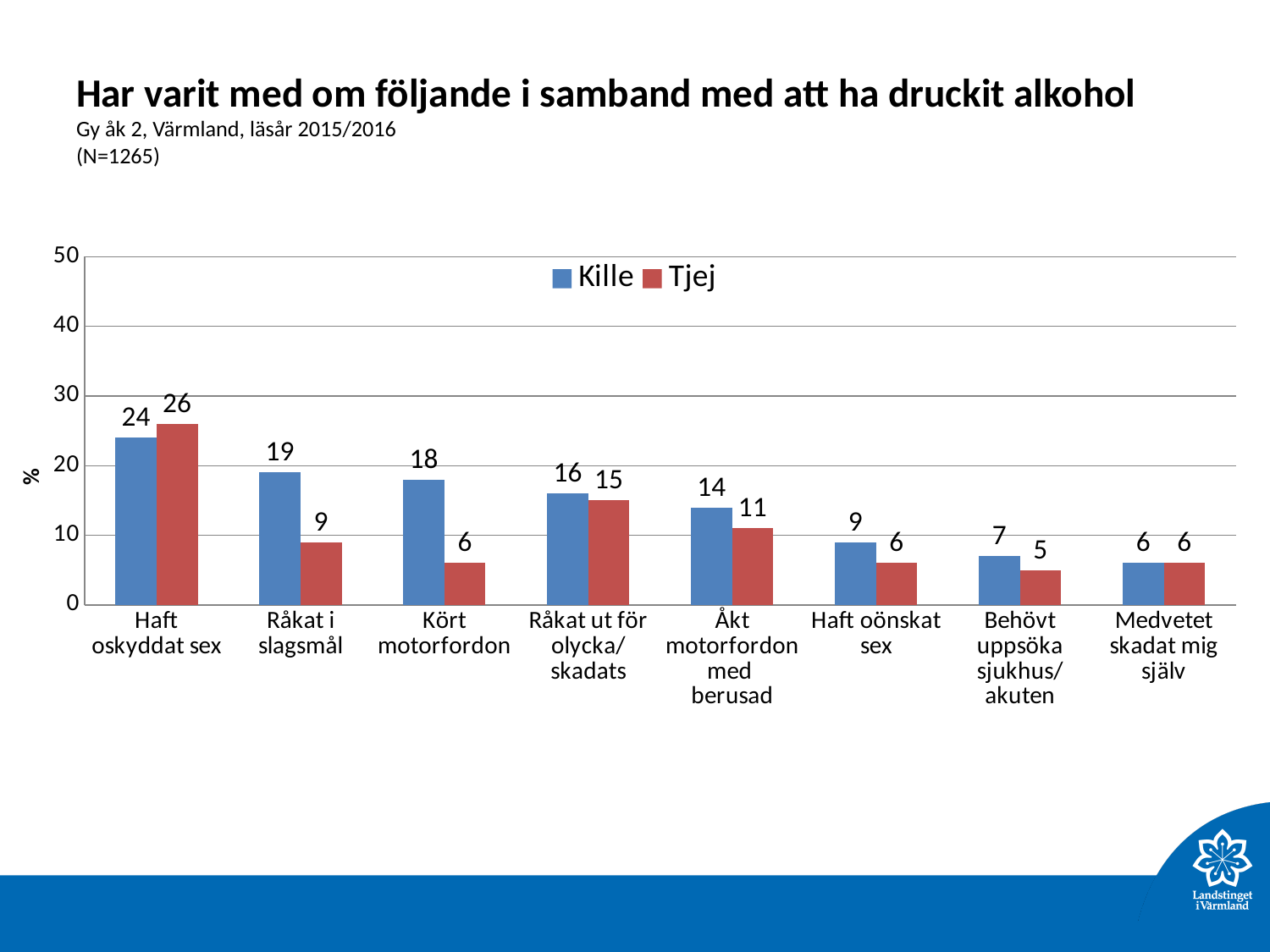
Is the value for Kille for "Råkat i slagsmål" greater or less than 10? greater What is the difference between Kille and Tjej for "Kört motorfordon"? 12 What is the title of the chart? Har varit med om följande i samband med att ha druckit alkohol Which category has the lowest value for Tjej? Behövt uppsöka sjukhus/akuten How many categories are shown on the x axis? 8 How many series does the legend list? 2 Which is larger for "Haft oskyddat sex", Kille or Tjej? Tjej What kind of chart is shown on the slide? bar chart Which category has the highest value for Tjej? Haft oskyddat sex What is the value for Tjej for "Råkat i slagsmål"? 9 What is the value for Kille for "Haft oskyddat sex"? 24 What is the value for Kille for "Åkt motorfordon med berusad"? 14